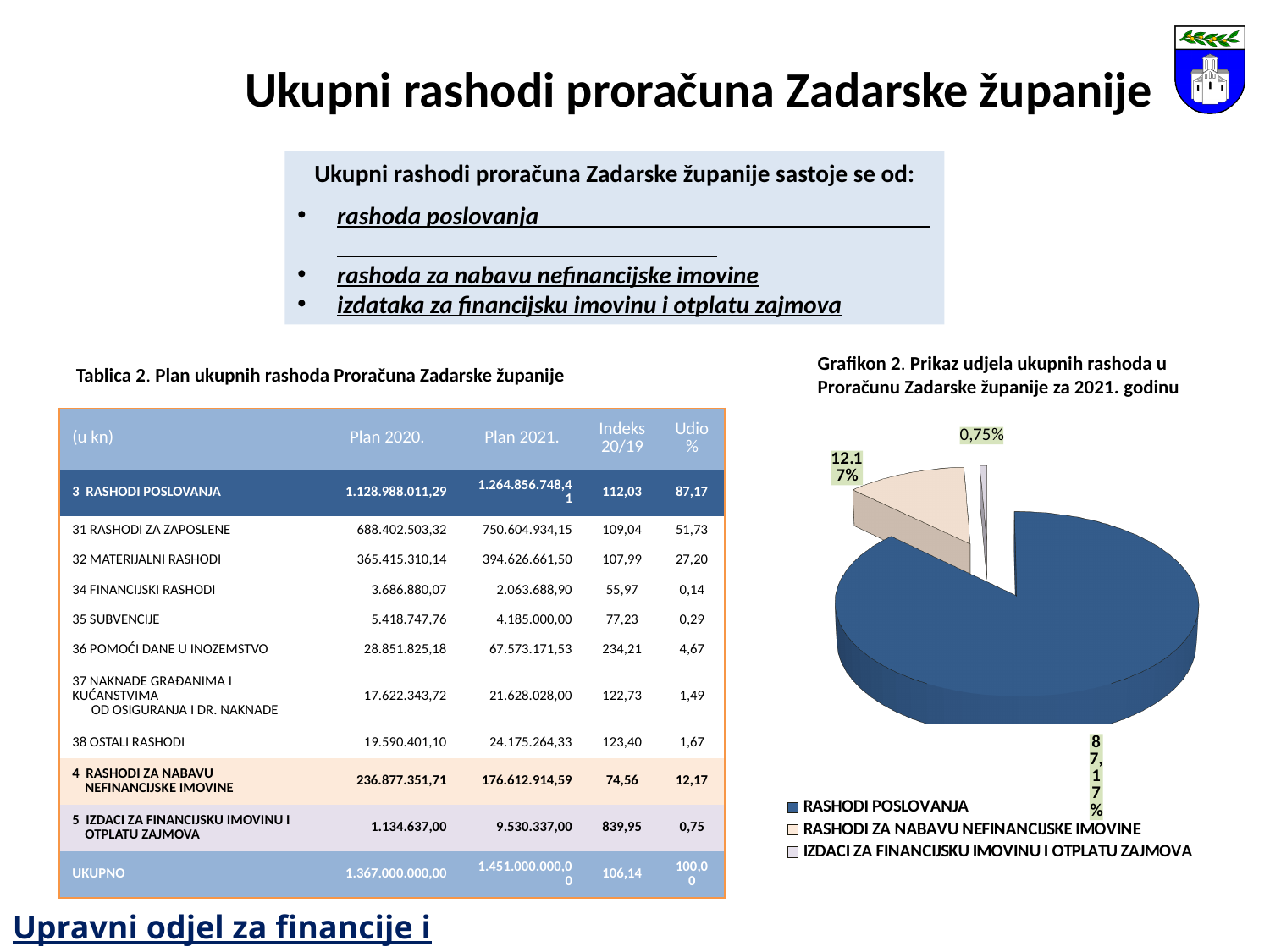
In Grafikon 2, which slice is larger: RASHODI ZA NABAVU NEFINANCIJSKE IMOVINE or IZDACI ZA FINANCIJSKU IMOVINU I OTPLATU ZAJMOVA? RASHODI ZA NABAVU NEFINANCIJSKE IMOVINE What is the title of the pie chart on the slide? Grafikon 2. Prikaz udjela ukupnih rashoda u Proračunu Zadarske županije za 2021. godinu In Grafikon 2, which legend entry is shown in dark blue? RASHODI POSLOVANJA How many slices does the pie chart in Grafikon 2 have? 3 How many entries does the legend of Grafikon 2 list? 3 In Grafikon 2, is the share for RASHODI POSLOVANJA greater or less than 50%? greater In Grafikon 2, what share of the pie is labelled for IZDACI ZA FINANCIJSKU IMOVINU I OTPLATU ZAJMOVA? 0,75% Which category has the largest slice in Grafikon 2? RASHODI POSLOVANJA In Grafikon 2, what share of the pie is labelled for RASHODI ZA NABAVU NEFINANCIJSKE IMOVINE? 12.17% What kind of chart is Grafikon 2 on the slide? pie chart Which category has the smallest slice in Grafikon 2? IZDACI ZA FINANCIJSKU IMOVINU I OTPLATU ZAJMOVA In Grafikon 2, what share of the pie is labelled for RASHODI POSLOVANJA? 87,17%